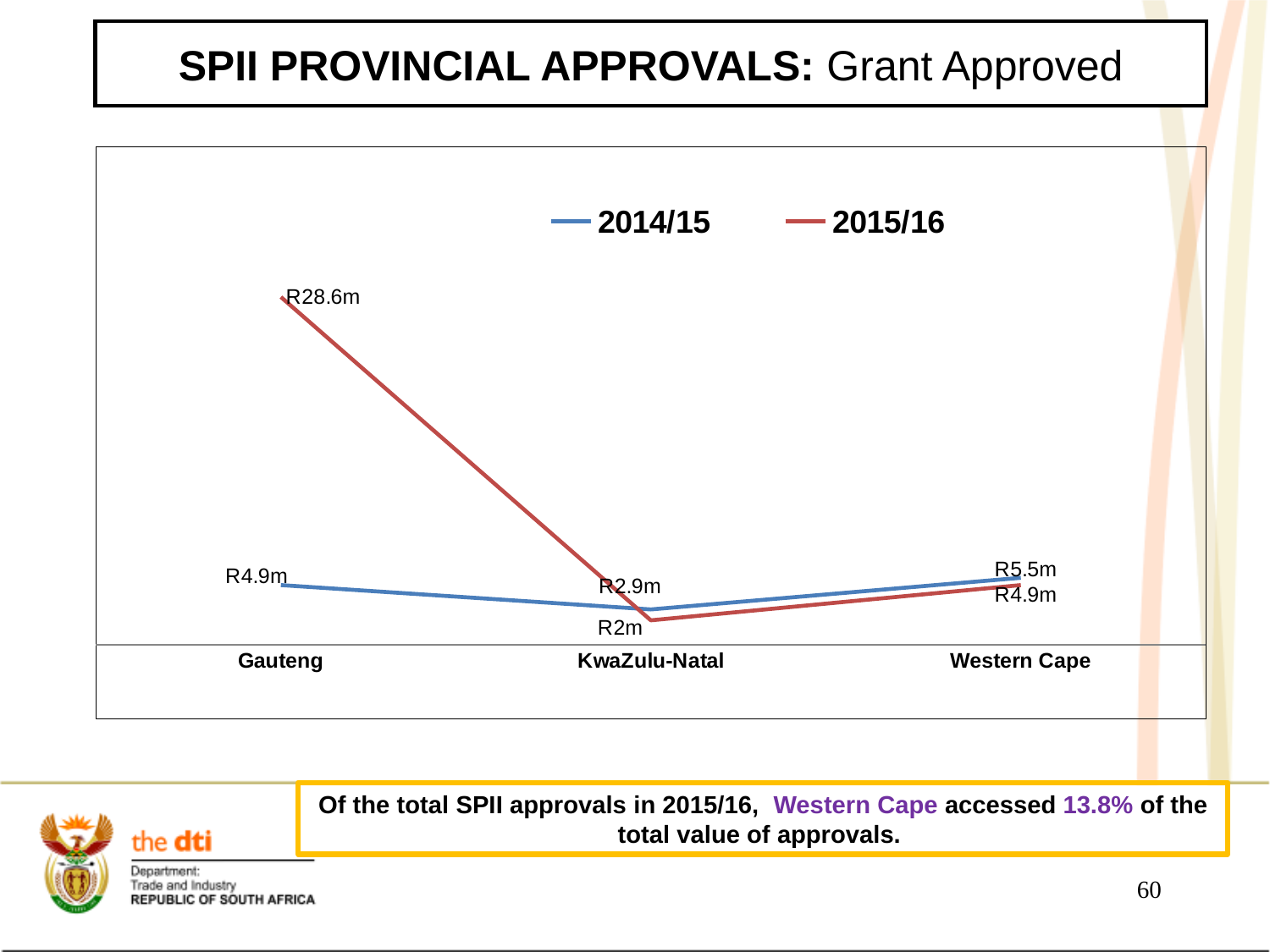
Which province had the lowest grant approved in 2014/15? KwaZulu-Natal What was the grant approved for KwaZulu-Natal in 2015/16? R2m Which province had the highest grant approved in 2015/16? Gauteng How many series does the legend list? 2 For Western Cape, which year had the larger grant approved, 2014/15 or 2015/16? 2014/15 What is the difference between the 2015/16 and 2014/15 grant approved for Gauteng? R23.7m What kind of chart is shown on the slide? line chart What was the grant approved for Gauteng in 2015/16? R28.6m How many provinces are shown on the x axis? 3 What was the grant approved for Gauteng in 2014/15? R4.9m Which colour represents the 2015/16 series in the chart? red What was the grant approved for Western Cape in 2014/15? R5.5m